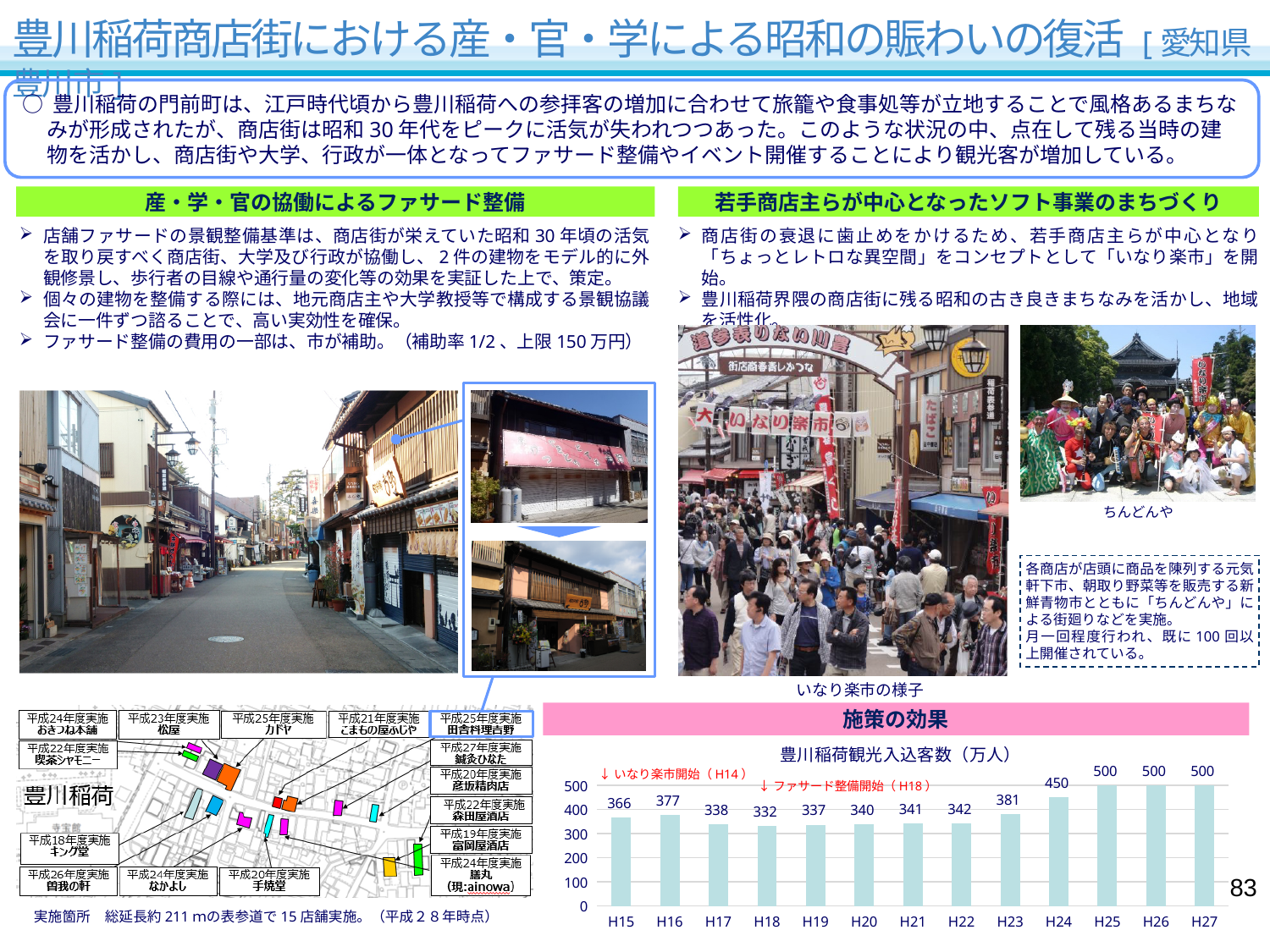
What is the difference between the values for H24 and H23 in the 豊川稲荷観光入込客数（万人） chart? 69 What is the value for H23 in the 豊川稲荷観光入込客数（万人） chart? 381 Which category has the lowest value in the 豊川稲荷観光入込客数（万人） chart? H18 How many categories are shown on the x axis of the 豊川稲荷観光入込客数（万人） chart? 13 What kind of chart is the 豊川稲荷観光入込客数（万人） chart? bar chart What is the value for H27 in the 豊川稲荷観光入込客数（万人） chart? 500 In the 豊川稲荷観光入込客数（万人） chart, which is larger, the value for H16 or the value for H22? H16 What is the title of the chart at the bottom right of the slide? 豊川稲荷観光入込客数（万人） What is the value for H15 in the 豊川稲荷観光入込客数（万人） chart? 366 What is the difference between the values for H16 and H15 in the 豊川稲荷観光入込客数（万人） chart? 11 What is the value for H24 in the 豊川稲荷観光入込客数（万人） chart? 450 In the 豊川稲荷観光入込客数（万人） chart, do the values rise or fall from H22 to H25? rise